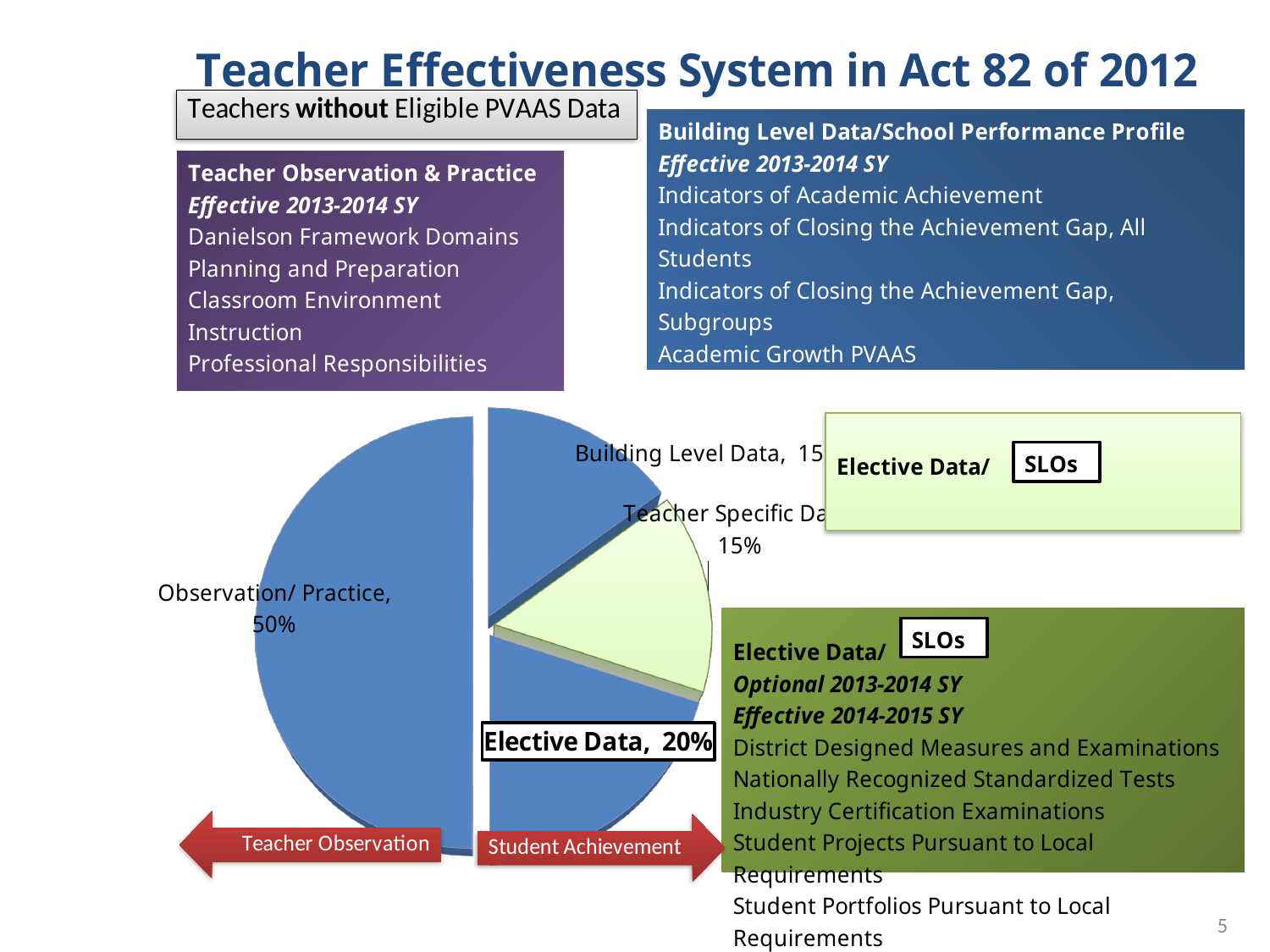
How many slices does the pie chart have? 4 What is the value for Elective Data in the pie chart? 20% What is the difference between the Observation/ Practice value and the Elective Data value in the pie chart? 30% Which is larger in the pie chart, Elective Data or Teacher Specific Data? Elective Data What colour is the Elective Data slice in the pie chart? Light green What kind of chart is shown on the slide? Pie chart Which slice of the pie chart is the largest? Observation/ Practice What is the difference between the Elective Data value and the Teacher Specific Data value in the pie chart? 5% What share of the pie does the Observation/ Practice slice represent? 50% Which is larger in the pie chart, Observation/ Practice or Elective Data? Observation/ Practice What is the value for Teacher Specific Data in the pie chart? 15% What is the value for Observation/ Practice in the pie chart? 50%